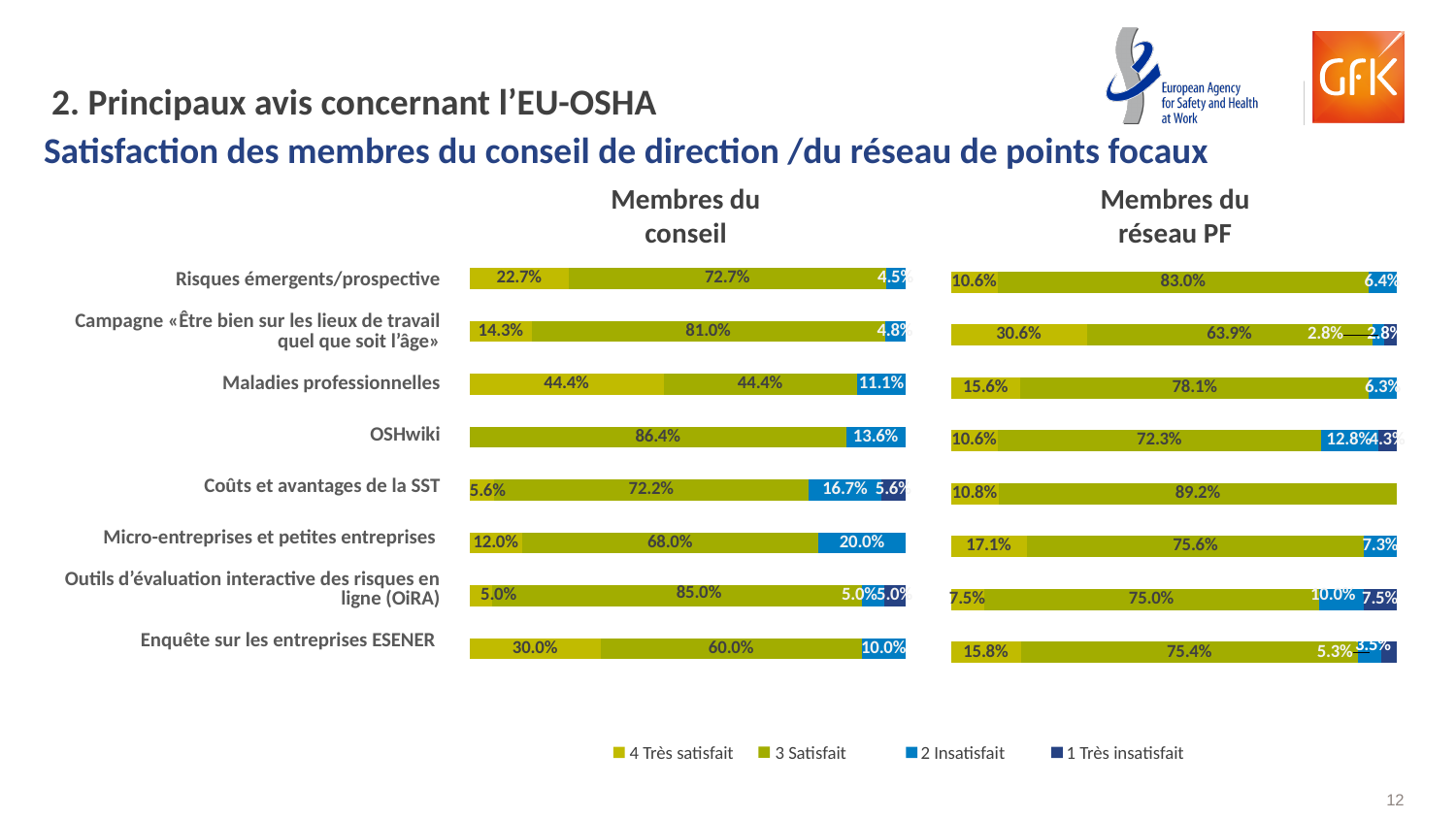
In the 'Membres du réseau PF' chart, what is the '3 Satisfait' value for 'Coûts et avantages de la SST'? 89.2% How many series does the legend list for the charts? 4 In the 'Membres du conseil' chart, which category has the highest '4 Très satisfait' value? Maladies professionnelles In the 'Membres du réseau PF' chart, which category has the highest '4 Très satisfait' value? Campagne «Être bien sur les lieux de travail quel que soit l'âge» What kind of chart is used on this slide for the 'Membres du conseil' and 'Membres du réseau PF' panels? Stacked bar chart In the 'Membres du réseau PF' chart, what is the '3 Satisfait' value for 'Maladies professionnelles'? 78.1% In the 'Membres du conseil' chart, what is the '2 Insatisfait' value for 'Micro-entreprises et petites entreprises'? 20.0% In the 'Membres du conseil' chart, what is the '3 Satisfait' value for OSHwiki? 86.4% How many categories (rows) are shown in the 'Membres du conseil' chart? 8 What is the legend label for the series shown in the lightest yellow-green colour? 4 Très satisfait In the 'Membres du conseil' chart, what is the difference between the '4 Très satisfait' and '2 Insatisfait' values for 'Maladies professionnelles'? 33.3 percentage points In the 'Membres du conseil' chart, which has the larger '3 Satisfait' value: 'Outils d'évaluation interactive des risques en ligne (OiRA)' or 'Enquête sur les entreprises ESENER'? Outils d'évaluation interactive des risques en ligne (OiRA)